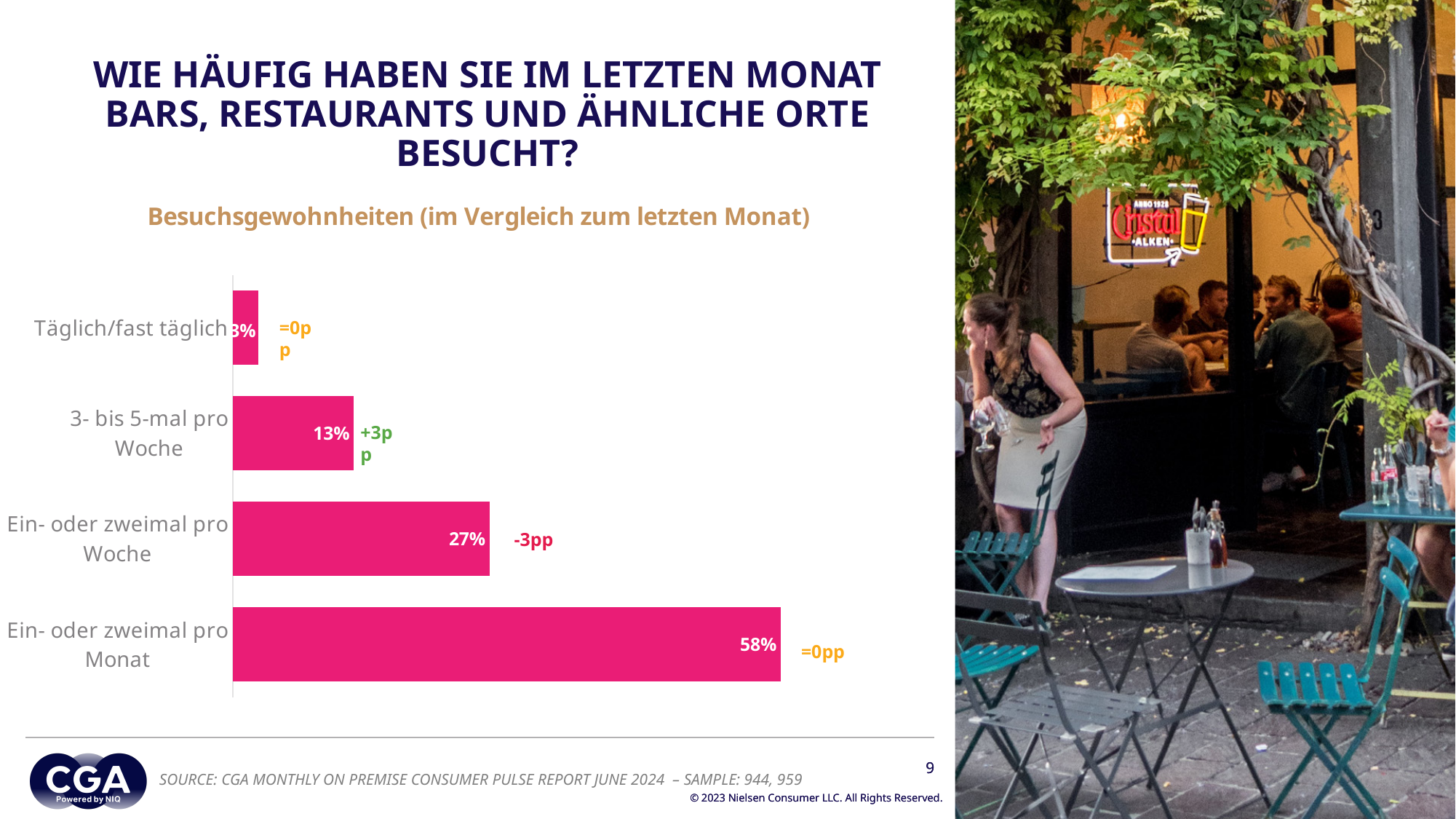
What is the difference between the values for 'Ein- oder zweimal pro Monat' and 'Ein- oder zweimal pro Woche'? 31 percentage points What is the value shown for 'Ein- oder zweimal pro Woche'? 27% What kind of chart is shown on the slide? Bar chart Which is larger: the value for '3- bis 5-mal pro Woche' or for 'Ein- oder zweimal pro Woche'? Ein- oder zweimal pro Woche What change compared to the previous month is shown next to the '3- bis 5-mal pro Woche' bar? +3pp What change compared to the previous month is shown next to the 'Ein- oder zweimal pro Woche' bar? -3pp How many categories are shown in the chart? 4 Which category has the highest value in the chart? Ein- oder zweimal pro Monat What is the title of the chart? Besuchsgewohnheiten (im Vergleich zum letzten Monat) What percentage of respondents visited bars, restaurants and similar places once or twice a month (Ein- oder zweimal pro Monat)? 58% Which category has the lowest value in the chart? Täglich/fast täglich What is the value shown for '3- bis 5-mal pro Woche'? 13%